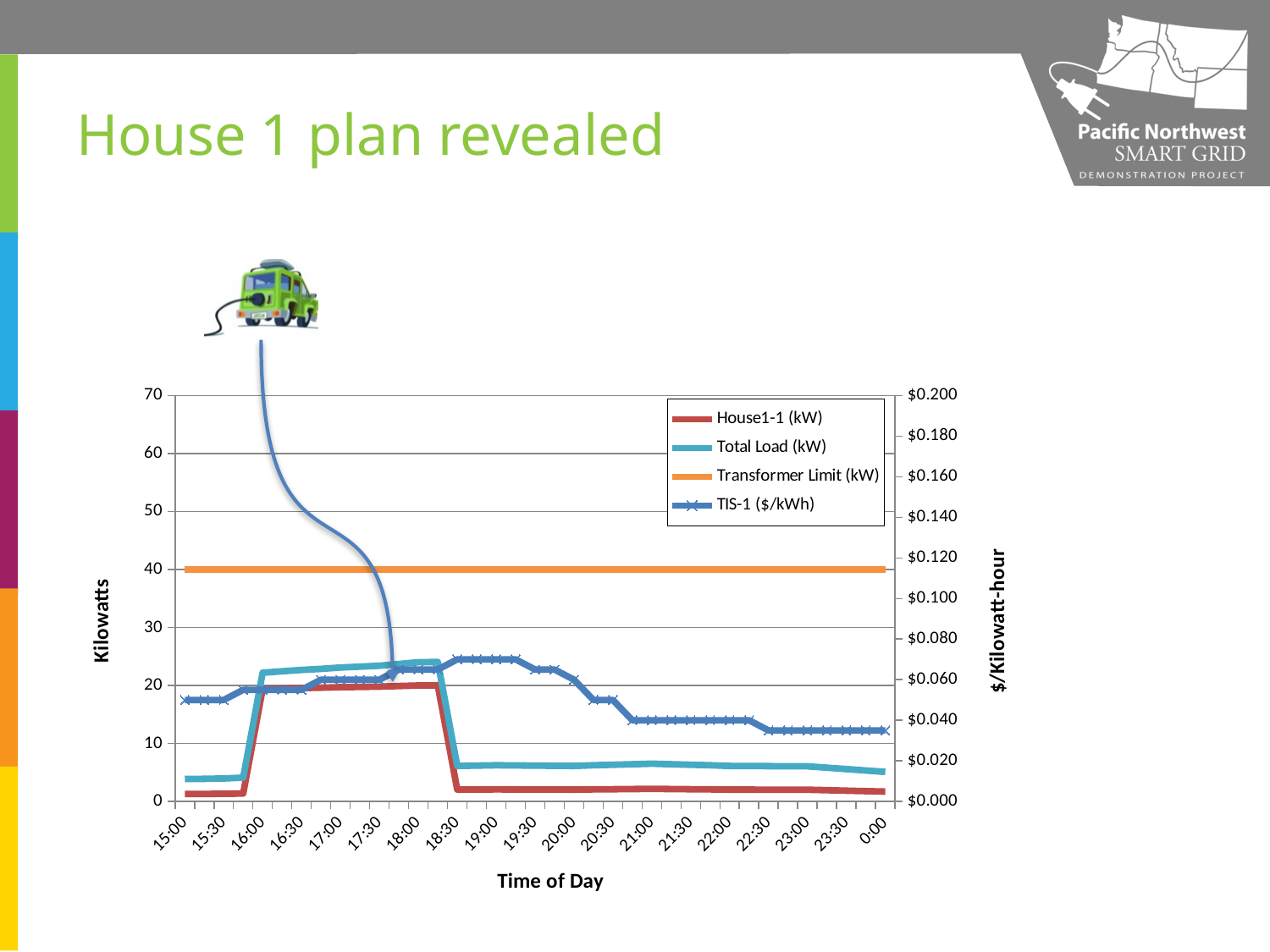
At 18:00, which is larger: Transformer Limit (kW) or Total Load (kW)? Transformer Limit (kW) What is the title of the left vertical axis? Kilowatts What is the value of the Transformer Limit (kW) series? 40 Is the House1-1 (kW) value at 17:00 greater or less than 10? greater Is the TIS-1 ($/kWh) value at 19:00 greater or less than $0.060? greater Does the TIS-1 ($/kWh) series rise or fall between 19:00 and 0:00? fall Is the TIS-1 ($/kWh) value at 23:00 greater or less than $0.060? less How many series does the chart legend list? 4 At 17:00, which is larger: Total Load (kW) or House1-1 (kW)? Total Load (kW) What kind of chart is shown on the slide? line chart